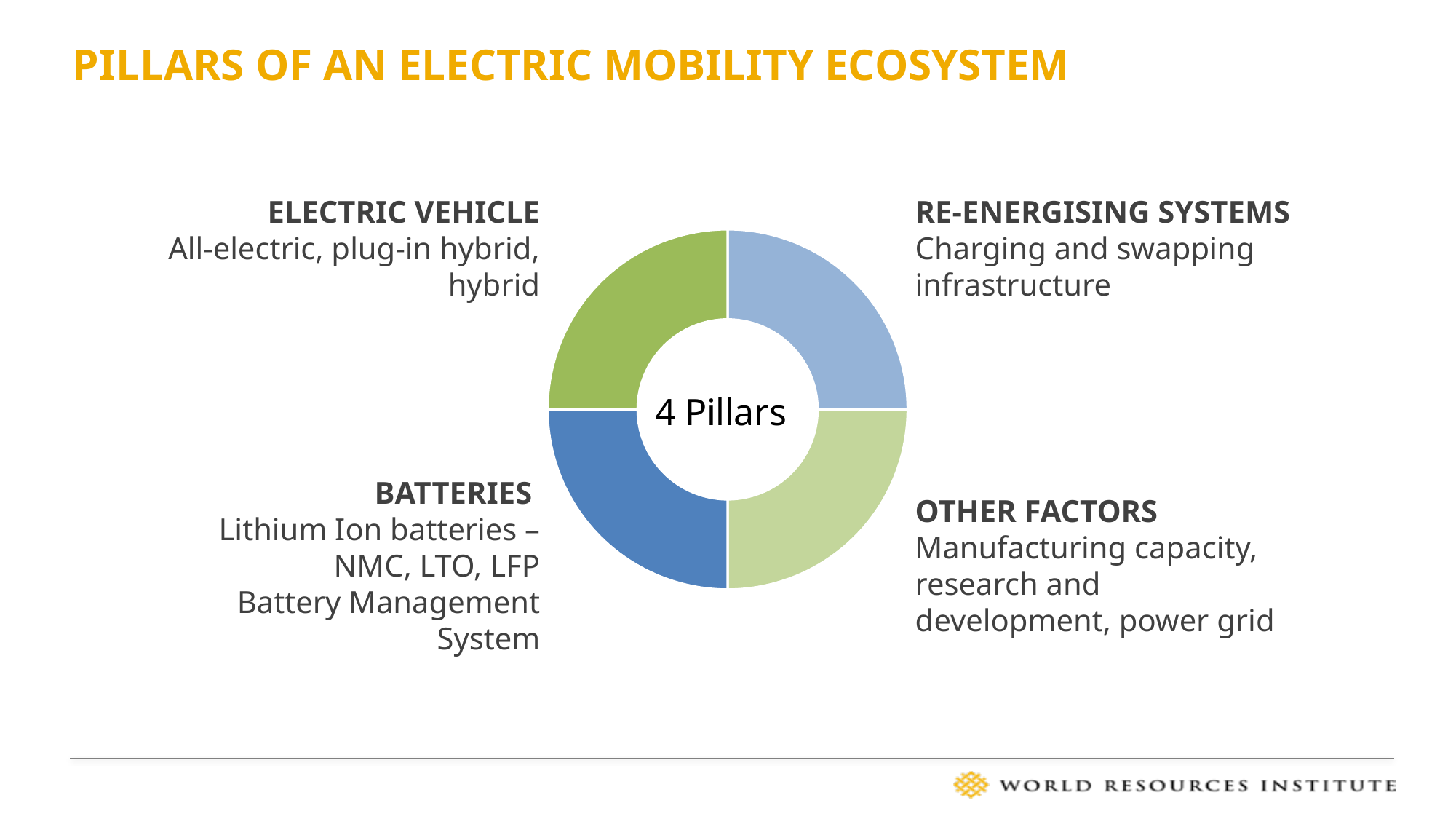
What text is printed in the centre of the doughnut chart? 4 Pillars Which pillar is labelled next to the top-left segment of the doughnut chart? ELECTRIC VEHICLE Which pillar is labelled next to the bottom-left segment of the doughnut chart? BATTERIES Which pillar is labelled next to the bottom-right segment of the doughnut chart? OTHER FACTORS Which pillar is labelled next to the top-right segment of the doughnut chart? RE-ENERGISING SYSTEMS Are the four segments of the doughnut chart equal in size? Yes How many segments does the doughnut chart have? 4 What kind of chart is shown on the slide? Doughnut chart What is the title of the slide containing the doughnut chart? PILLARS OF AN ELECTRIC MOBILITY ECOSYSTEM